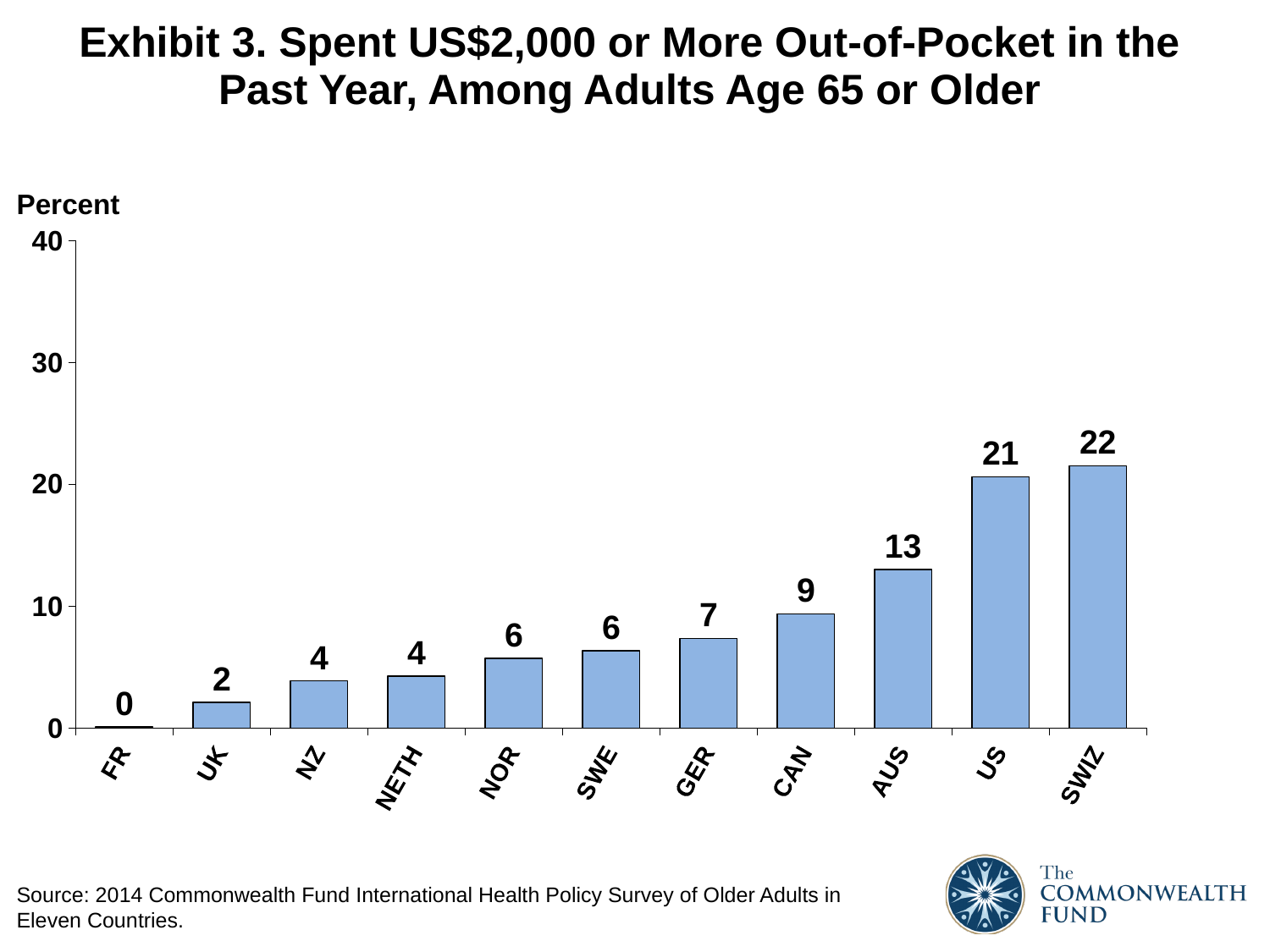
Is the value for the US greater or less than 20? greater What kind of chart is this? bar chart Which has a larger value, CAN or NOR? CAN Do the values rise or fall from left to right along the x axis? rise Which country has the lowest value? FR What percent is shown for CAN? 9 What is the difference between the values for AUS and GER? 6 What is the value for AUS? 13 What is the difference between the values for SWIZ and the UK? 20 How many countries are shown on the chart? 11 Which country has the highest value? SWIZ What is the value for the US? 21